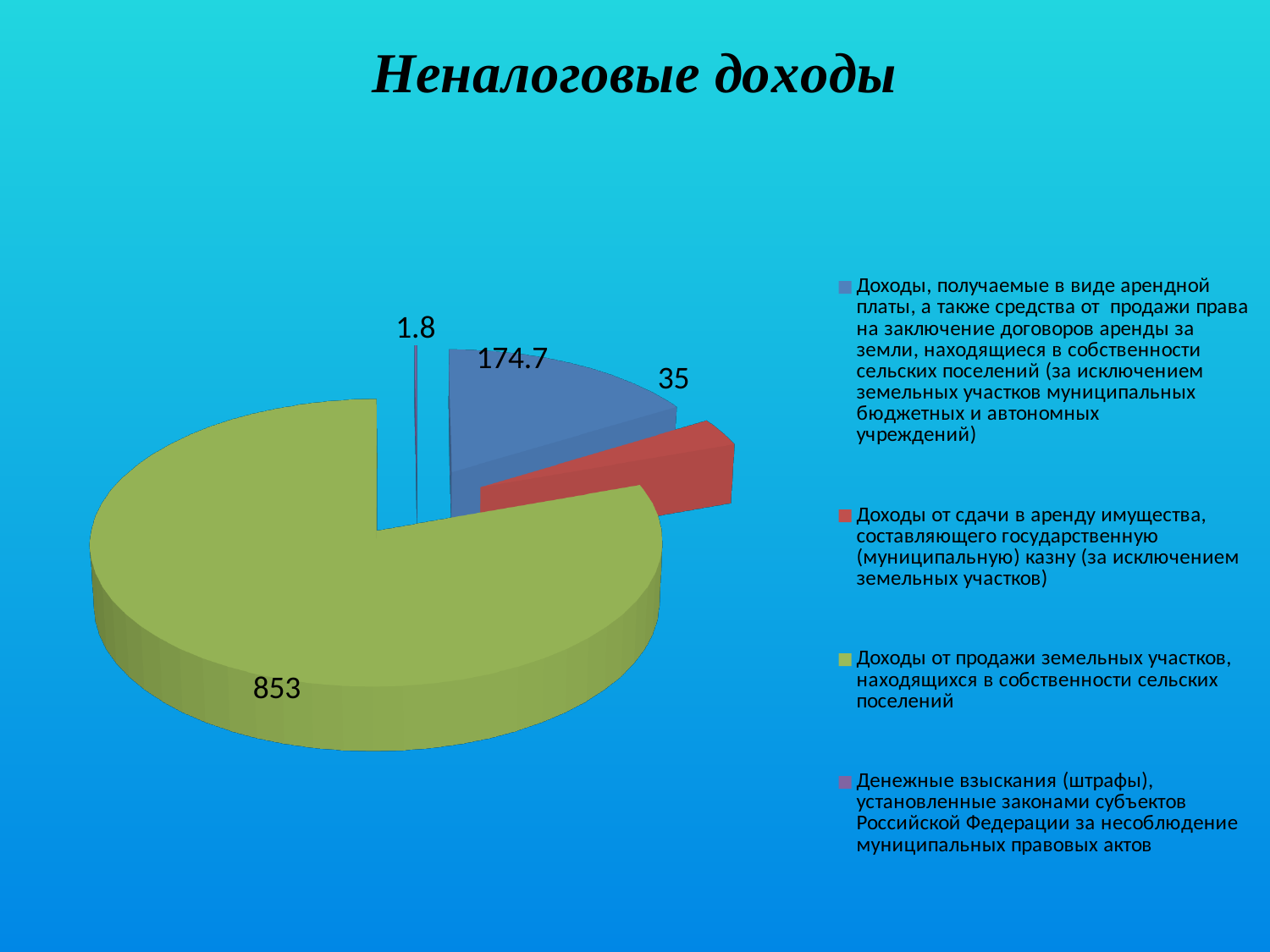
What is the value of the blue slice (Доходы, получаемые в виде арендной платы)? 174.7 What type of chart is shown on the slide? Pie chart Which is larger: the slice for rental income (Доходы, получаемые в виде арендной платы) or the slice for property rental (Доходы от сдачи в аренду имущества)? Доходы, получаемые в виде арендной платы What is the value of the slice for 'Денежные взыскания (штрафы)'? 1.8 What is the title of the chart? Неналоговые доходы What is the value of the slice for 'Доходы от продажи земельных участков, находящихся в собственности сельских поселений'? 853 Which category has the largest slice? Доходы от продажи земельных участков, находящихся в собственности сельских поселений What is the difference between the largest slice (853) and the blue slice (174.7)? 678.3 How many slices does the pie chart have? 4 How many entries does the legend list? 4 What is the value of the slice for 'Доходы от сдачи в аренду имущества, составляющего государственную (муниципальную) казну'? 35 Which category has the smallest slice? Денежные взыскания (штрафы)